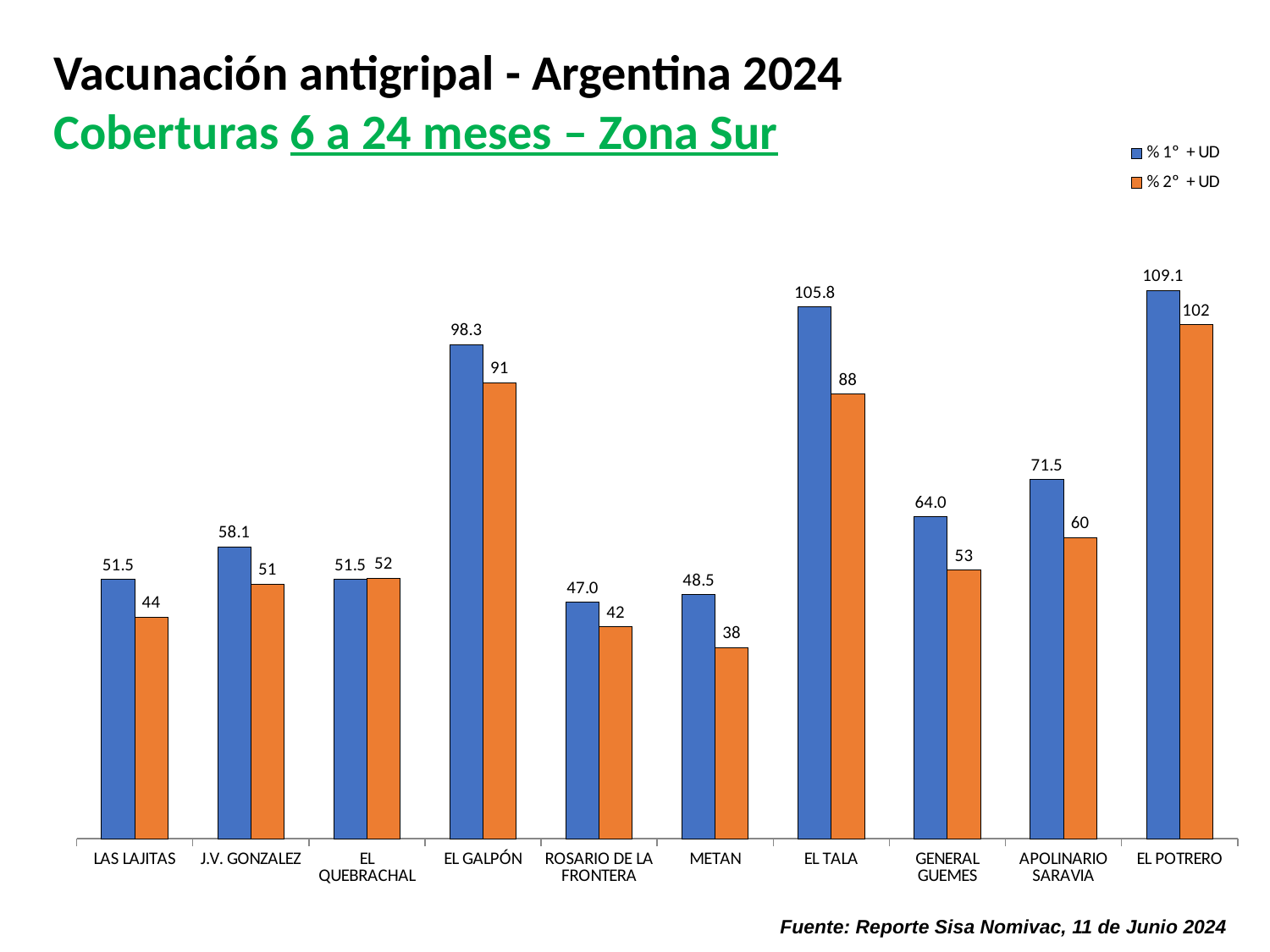
What is the value of % 2° + UD for EL GALPÓN? 91 Which is larger for EL QUEBRACHAL: % 1° + UD or % 2° + UD? % 2° + UD What kind of chart is shown on the slide? Bar chart Which locality has the higher % 2° + UD value: GENERAL GUEMES or APOLINARIO SARAVIA? APOLINARIO SARAVIA How many localities are shown on the x axis of the chart? 10 Which locality has the lowest % 2° + UD value? METAN What is the value of % 1° + UD for EL TALA? 105.8 Which locality has the lowest % 1° + UD value? ROSARIO DE LA FRONTERA How many series does the legend list? 2 What is the value of % 2° + UD for METAN? 38 What is the difference between the % 1° + UD and % 2° + UD values for EL TALA? 17.8 Which locality has the highest % 1° + UD value? EL POTRERO